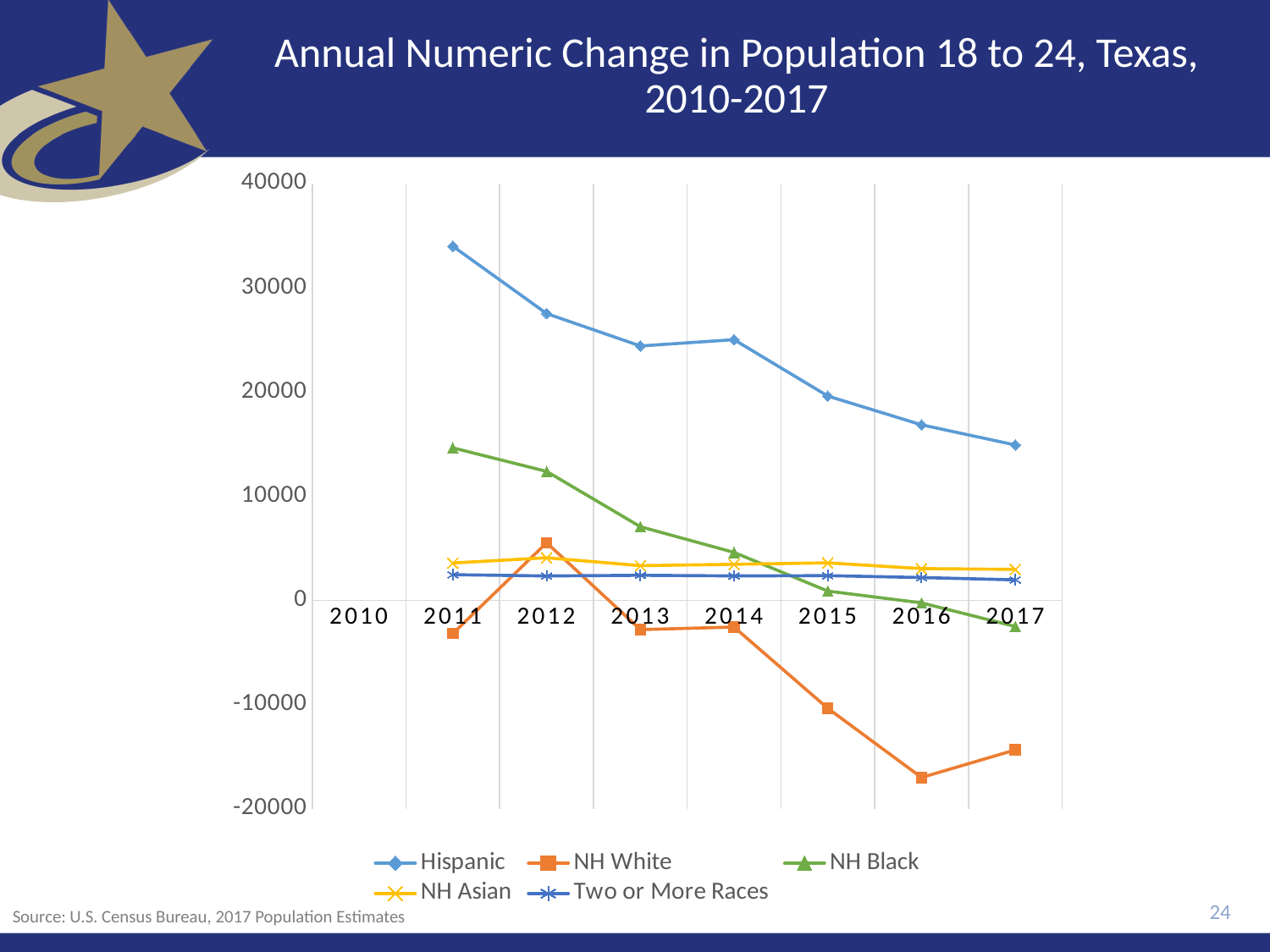
How many years are labelled on the x axis? 8 How many series does the legend list? 5 Is the value for NH White in 2016 greater or less than -10000? less What is the title of the chart? Annual Numeric Change in Population 18 to 24, Texas, 2010-2017 Does the Hispanic series rise or fall from 2011 to 2017? Fall Which series has the highest value in 2011? Hispanic Is the value for NH Black in 2011 greater or less than 10000? greater Which series has the lowest value in 2017? NH White Is the value for Hispanic in 2017 greater or less than 20000? less In 2012, which is larger: NH Black or NH Asian? NH Black What kind of chart is shown on the slide? Line chart